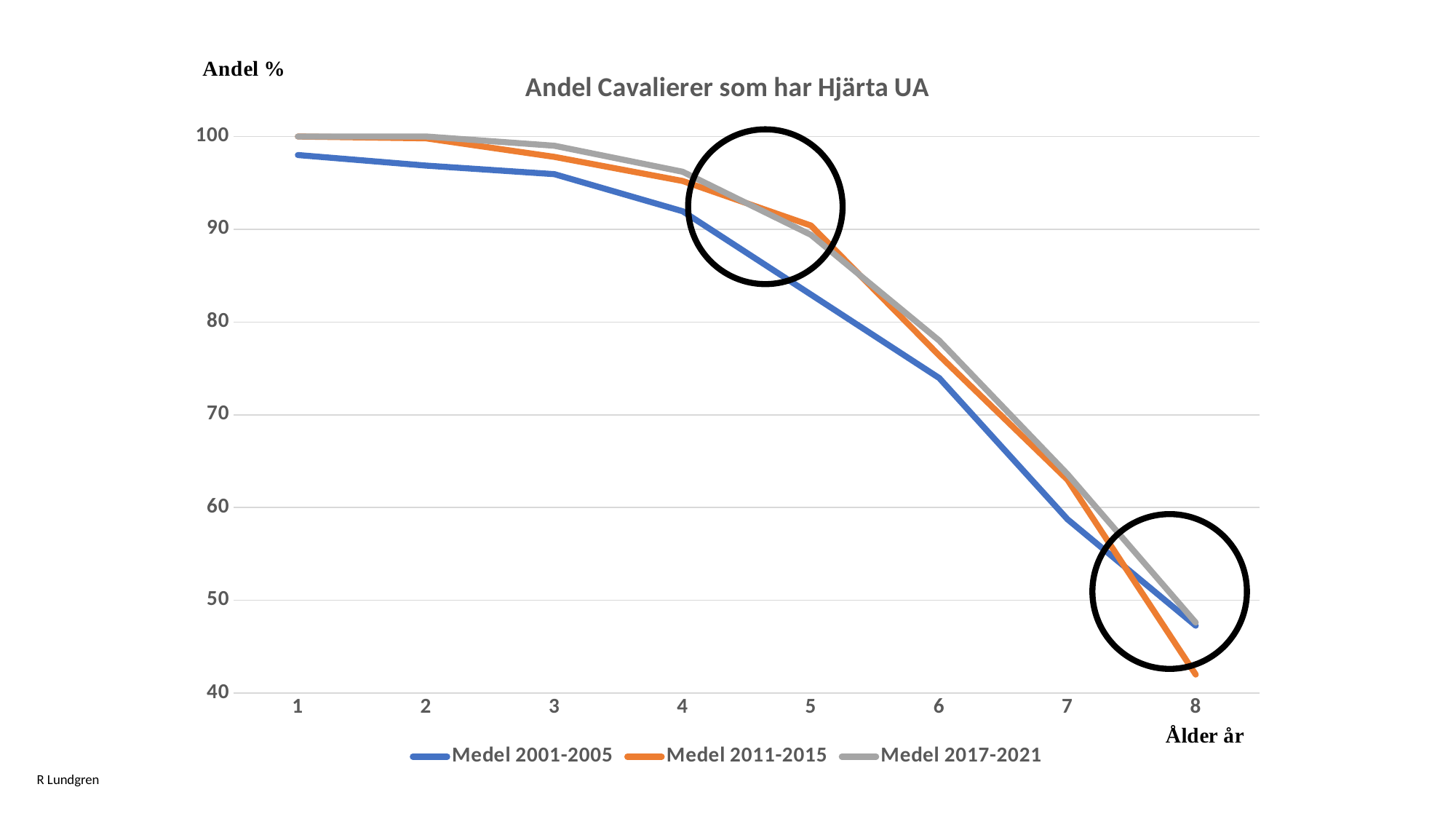
Which series has the lowest value at age 8? Medel 2011-2015 Is the value for Medel 2001-2005 at age 6 greater or less than 70? greater What is the title of the chart? Andel Cavalierer som har Hjärta UA What is the value for Medel 2017-2021 at age 1? 100 Is the value for Medel 2001-2005 at age 8 greater or less than 50? less Do the values for Medel 2001-2005 rise or fall as age increases along the x axis? fall Is the value for Medel 2011-2015 at age 8 greater or less than 50? less What kind of chart is shown on the slide? line chart How many series does the legend list? 3 How many age categories are shown on the x axis? 8 At age 8, which is larger: the value for Medel 2001-2005 or the value for Medel 2011-2015? Medel 2001-2005